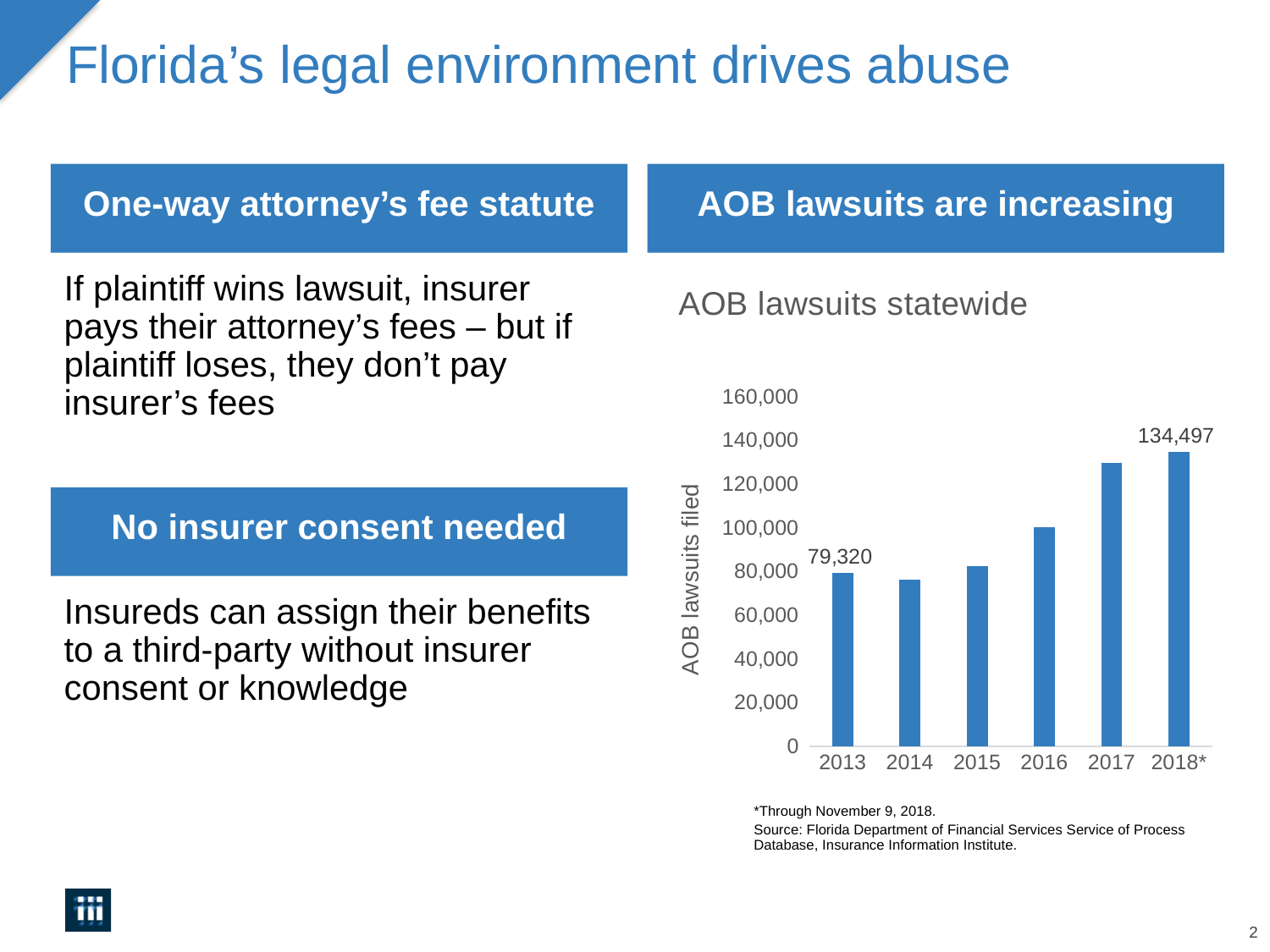
Which year has the highest number of AOB lawsuits filed? 2018* What kind of chart is used to show AOB lawsuits statewide? bar chart Which is larger, the value for 2017 or the value for 2016? 2017 Do AOB lawsuits filed generally rise or fall from 2014 to 2018*? rise What is the value for 2013 in the AOB lawsuits statewide chart? 79,320 Is the value for 2015 greater or less than 100,000? less What is the label on the vertical axis of the AOB lawsuits statewide chart? AOB lawsuits filed Is the value for 2016 greater or less than 120,000? less What is the value for 2018* in the AOB lawsuits statewide chart? 134,497 How many years are shown on the x axis of the AOB lawsuits statewide chart? 6 Is the value for 2017 greater or less than 120,000? greater What is the difference between the 2018* value and the 2013 value in the AOB lawsuits statewide chart? 55,177